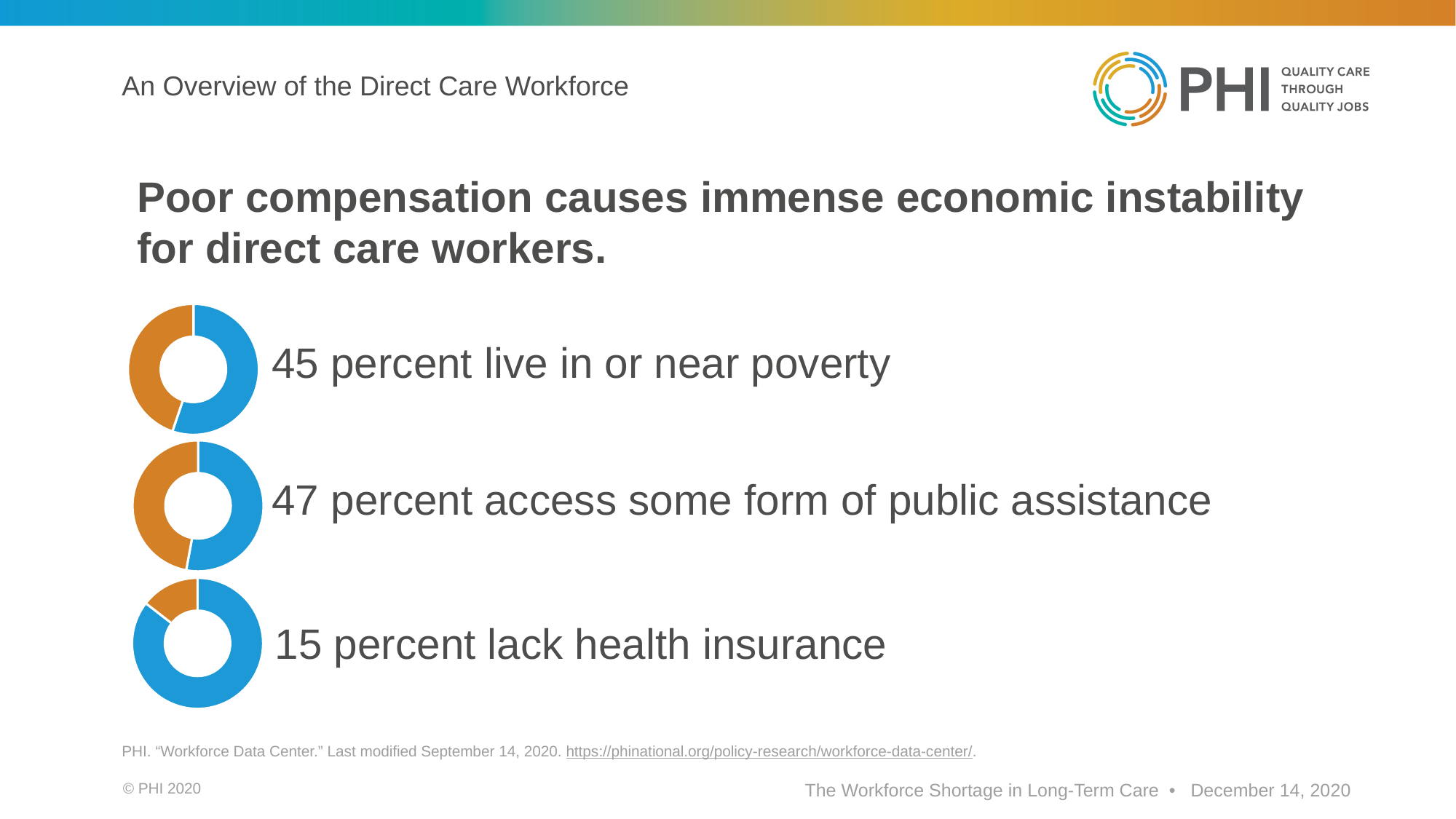
What percentage of direct care workers lack health insurance, according to the bottom donut chart? 15 percent Which is larger: the share who live in or near poverty or the share who lack health insurance? The share who live in or near poverty How many donut charts are on the slide? 3 In the bottom donut chart, what share does the orange slice represent? 15 percent What kind of charts are shown on the slide? Donut (pie) charts What colour is used for the highlighted slice in each donut chart? Orange Which of the three statistics shown has the lowest value? 15 percent lack health insurance What percentage of direct care workers live in or near poverty, according to the top donut chart? 45 percent What percentage of direct care workers access some form of public assistance, according to the middle donut chart? 47 percent What is the difference between the percentage who live in or near poverty and the percentage who lack health insurance? 30 percent What is the difference between the percentage who access public assistance and the percentage who live in or near poverty? 2 percent Which of the three statistics shown has the highest value? 47 percent access some form of public assistance